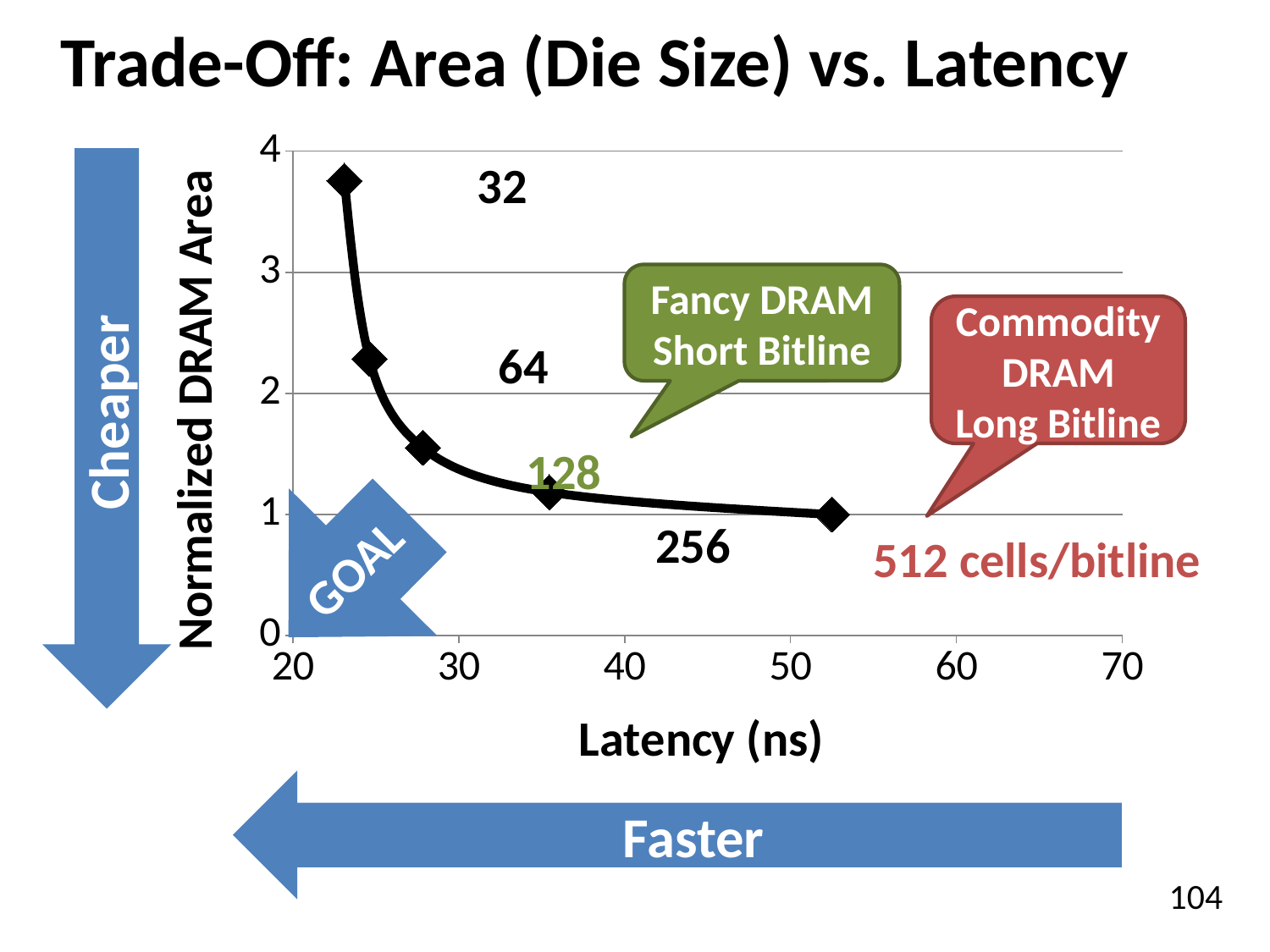
How many data points are plotted on the chart? 5 Is the latency for the 512 cells/bitline point greater or less than 50? greater Which point has the lowest latency? 32 Is the normalized DRAM area for the 32 cells/bitline point greater or less than 3? greater Which has a larger normalized DRAM area, the 64 point or the 256 point? 64 As latency increases along the x axis, does the normalized DRAM area rise or fall? fall Which point has the lowest normalized DRAM area? 512 cells/bitline What type of chart is shown on the slide? line chart What is the label of the y axis? Normalized DRAM Area Which point has the highest normalized DRAM area? 32 Which point has the highest latency? 512 cells/bitline What is the label of the x axis? Latency (ns)